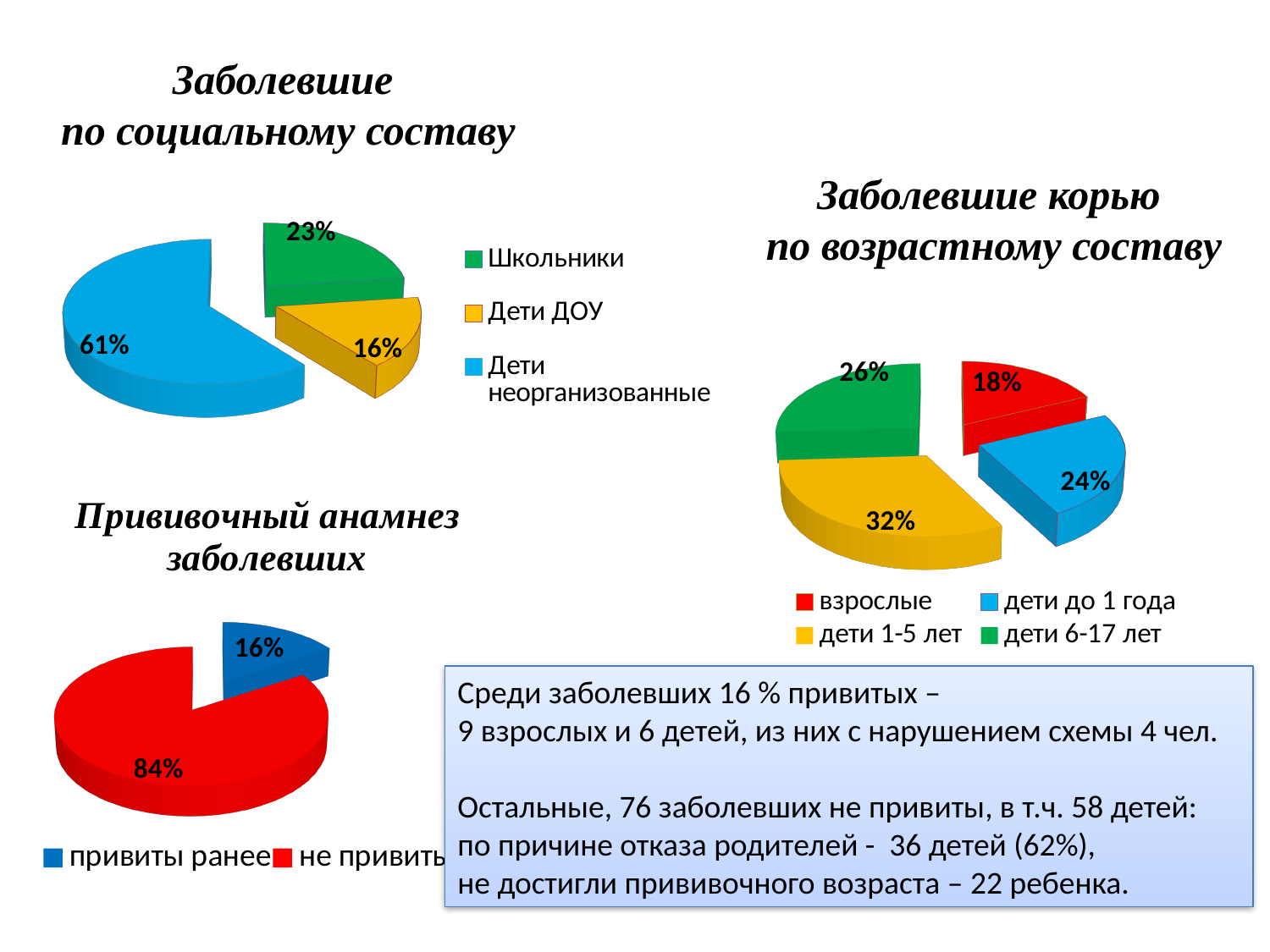
In the chart 'Заболевшие по социальному составу', what share is labelled for Школьники? 23% In the chart 'Заболевшие корью по возрастному составу', what share is labelled for взрослые? 18% In the chart 'Прививочный анамнез заболевших', what is the difference between the shares for не привиты and привиты ранее? 68% In the chart 'Заболевшие корью по возрастному составу', which category has the smallest slice? взрослые In the chart 'Заболевшие по социальному составу', what is the difference between the shares for Дети неорганизованные and Школьники? 38% In the chart 'Заболевшие корью по возрастному составу', what share is labelled for дети 1-5 лет? 32% In the chart 'Заболевшие по социальному составу', which category has the smallest slice? Дети ДОУ In the chart 'Прививочный анамнез заболевших', what share is labelled for не привиты? 84% What kind of chart is 'Прививочный анамнез заболевших'? Pie chart In the chart 'Заболевшие корью по возрастному составу', which is larger: дети до 1 года or дети 6-17 лет? дети 6-17 лет How many categories does the legend of the chart 'Заболевшие корью по возрастному составу' list? 4 In the chart 'Заболевшие по социальному составу', which category has the largest slice? Дети неорганизованные